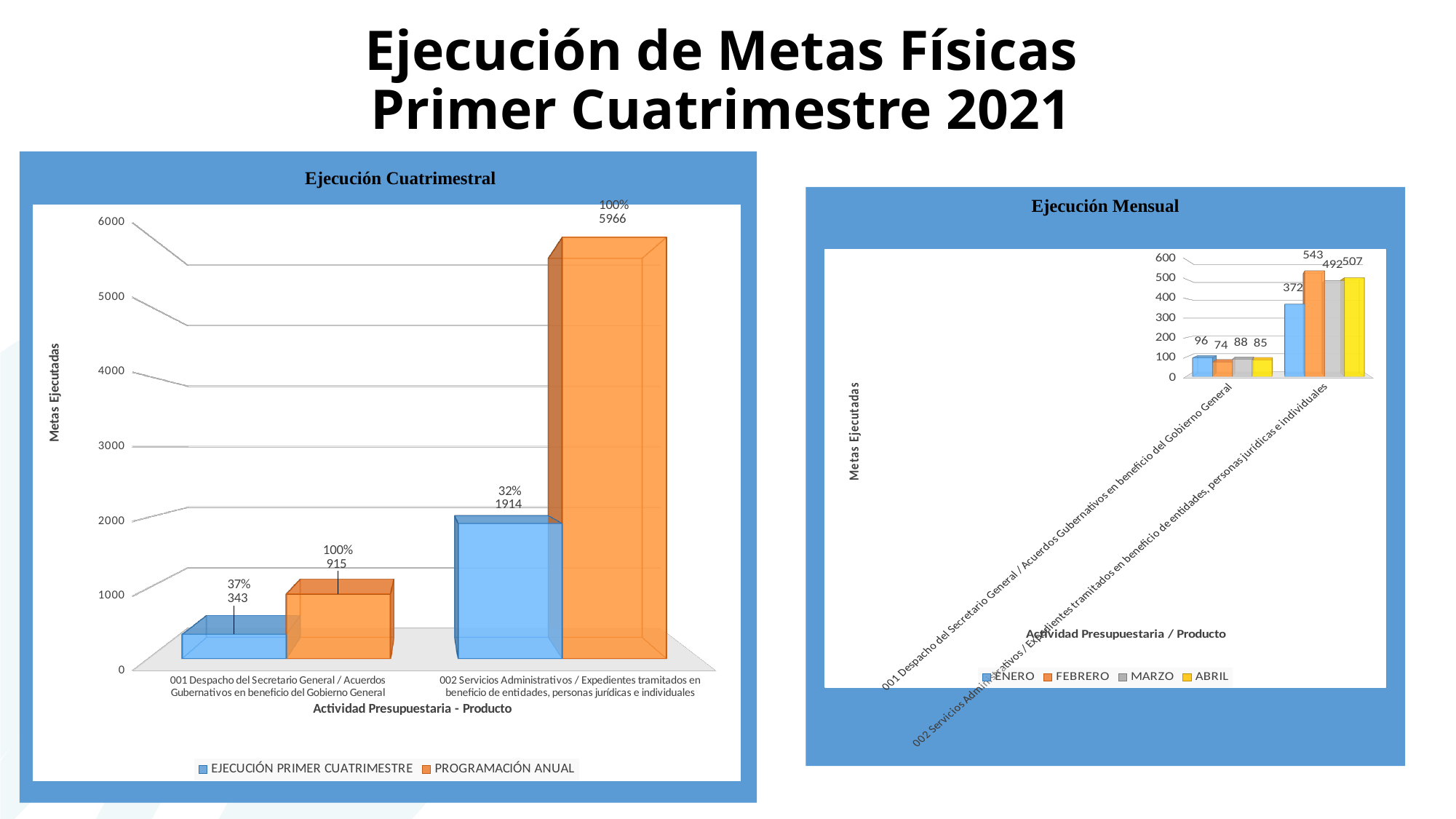
How many series does the legend of the 'Ejecución Cuatrimestral' chart list? 2 In the 'Ejecución Cuatrimestral' chart, what is the PROGRAMACIÓN ANUAL value for 001 Despacho del Secretario General? 915 In the 'Ejecución Cuatrimestral' chart, what is the EJECUCIÓN PRIMER CUATRIMESTRE value for 002 Servicios Administrativos? 1914 In the 'Ejecución Cuatrimestral' chart, which bar is the tallest? PROGRAMACIÓN ANUAL for 002 Servicios Administrativos (5966) What kind of chart is 'Ejecución Mensual'? Bar chart In the 'Ejecución Mensual' chart, what is the ENERO value for 001 Despacho del Secretario General? 96 In the 'Ejecución Cuatrimestral' chart, what percentage is shown above the EJECUCIÓN PRIMER CUATRIMESTRE bar for 001 Despacho del Secretario General? 37% In the 'Ejecución Cuatrimestral' chart, what is the difference between PROGRAMACIÓN ANUAL and EJECUCIÓN PRIMER CUATRIMESTRE for 002 Servicios Administrativos? 4052 In the 'Ejecución Mensual' chart, what is the FEBRERO value for 002 Servicios Administrativos? 543 In the 'Ejecución Mensual' chart, what is the difference between the ABRIL and MARZO values for 002 Servicios Administrativos? 15 How many series does the legend of the 'Ejecución Mensual' chart list? 4 In the 'Ejecución Mensual' chart, which month has the lowest value for 001 Despacho del Secretario General? FEBRERO